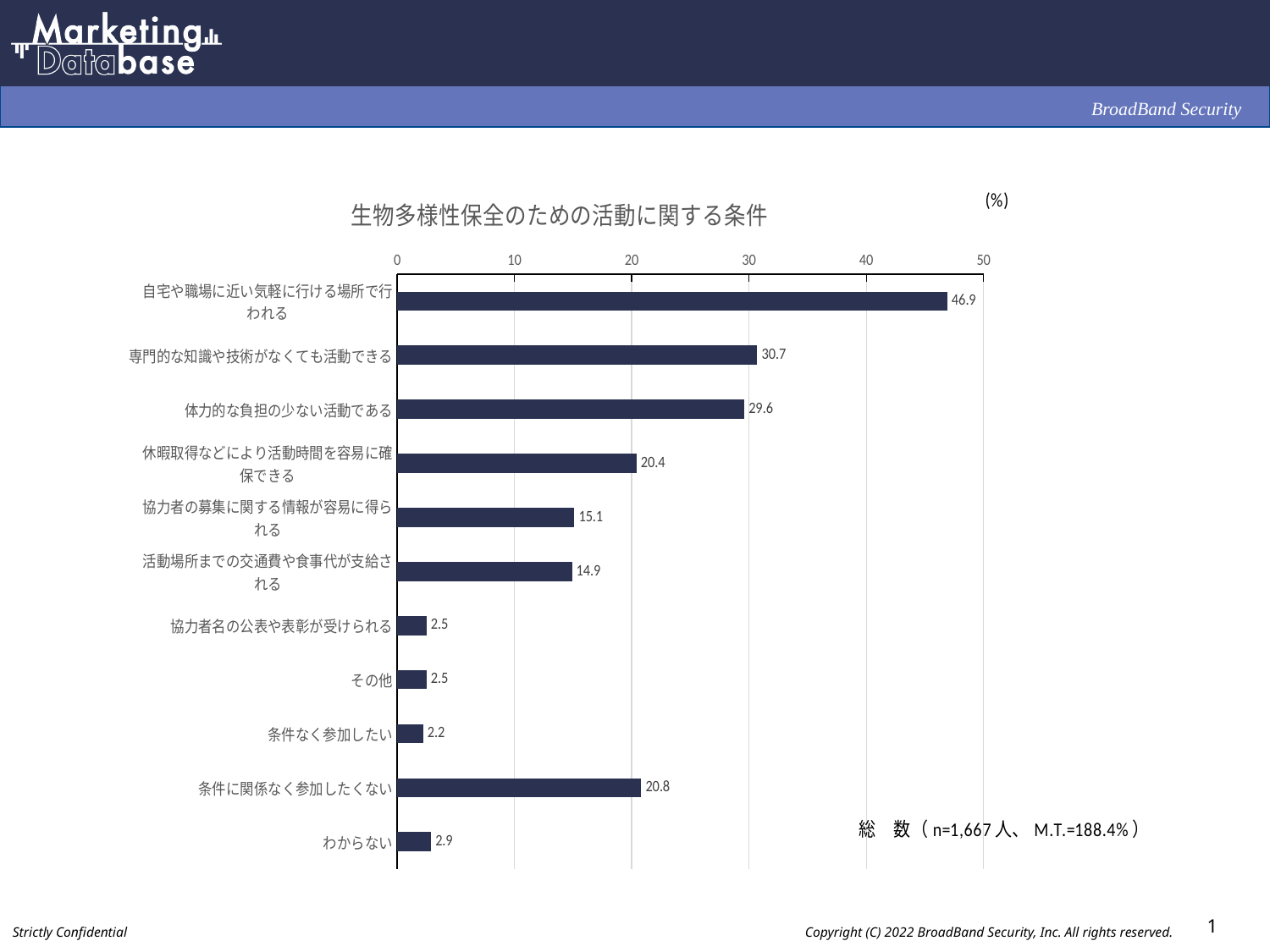
Which is larger, 休暇取得などにより活動時間を容易に確保できる or 条件に関係なく参加したくない? 条件に関係なく参加したくない Which category has the highest value? 自宅や職場に近い気軽に行ける場所で行われる How many categories are shown in the chart? 11 What kind of chart is shown on the slide? Bar chart What is the sample size (n) shown on the slide? 1,667 What is the value for 体力的な負担の少ない活動である? 29.6 Which category has the lowest value? 条件なく参加したい What is the value for 条件に関係なく参加したくない? 20.8 What is the title of the chart? 生物多様性保全のための活動に関する条件 What is the value for 自宅や職場に近い気軽に行ける場所で行われる? 46.9 Is the value for 専門的な知識や技術がなくても活動できる greater or less than 30? greater What is the difference between 専門的な知識や技術がなくても活動できる and 体力的な負担の少ない活動である? 1.1